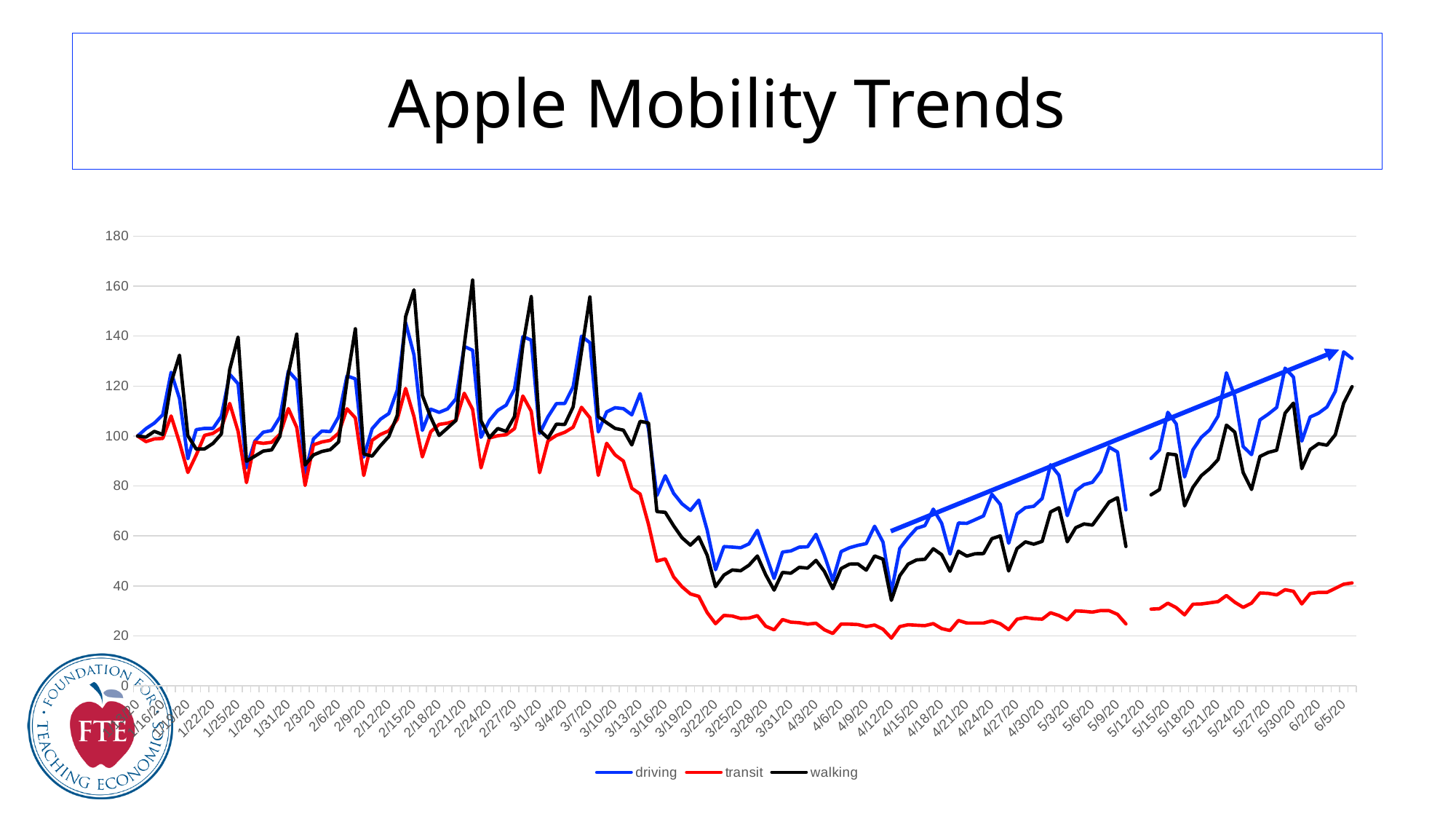
Is the value for transit on 6/5/20 greater or less than 60? less On 4/6/20, which is larger, transit or walking? walking How many series does the legend list? 3 Which series reaches the highest value anywhere on the chart? walking On 6/5/20, which is larger, driving or transit? driving Do the driving values rise or fall between 4/12/20 and 6/5/20? rise Which colour is used for the transit series? red Is the value for driving on 6/5/20 greater or less than 120? greater Is the value for walking on 2/15/20 greater or less than 140? greater What is the title of the chart? Apple Mobility Trends What kind of chart is shown on the slide? line chart